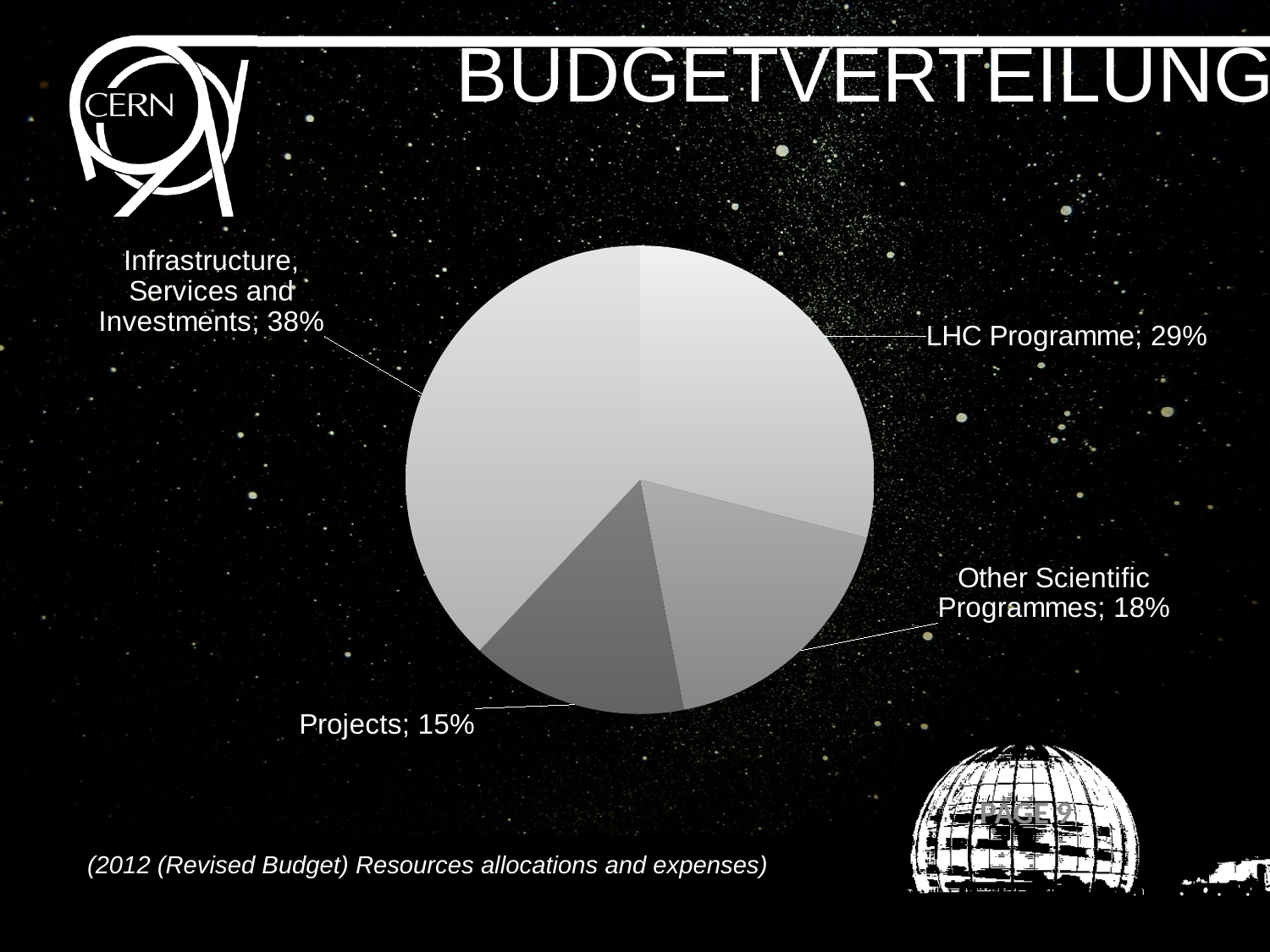
How many categories are shown in the pie chart? 4 Which is larger, the share for Other Scientific Programmes or the share for Projects? Other Scientific Programmes What is the title of the slide containing the chart? BUDGETVERTEILUNG What share of the budget goes to Other Scientific Programmes? 18% What share of the budget goes to Infrastructure, Services and Investments? 38% Which category has the smallest share of the budget? Projects What kind of chart is shown on the slide? pie chart Which category has the largest share of the budget? Infrastructure, Services and Investments What share of the budget goes to the LHC Programme? 29% What is the difference in percentage points between Infrastructure, Services and Investments and the LHC Programme? 9 What is the combined share of the LHC Programme and Other Scientific Programmes? 47% What share of the budget goes to Projects? 15%